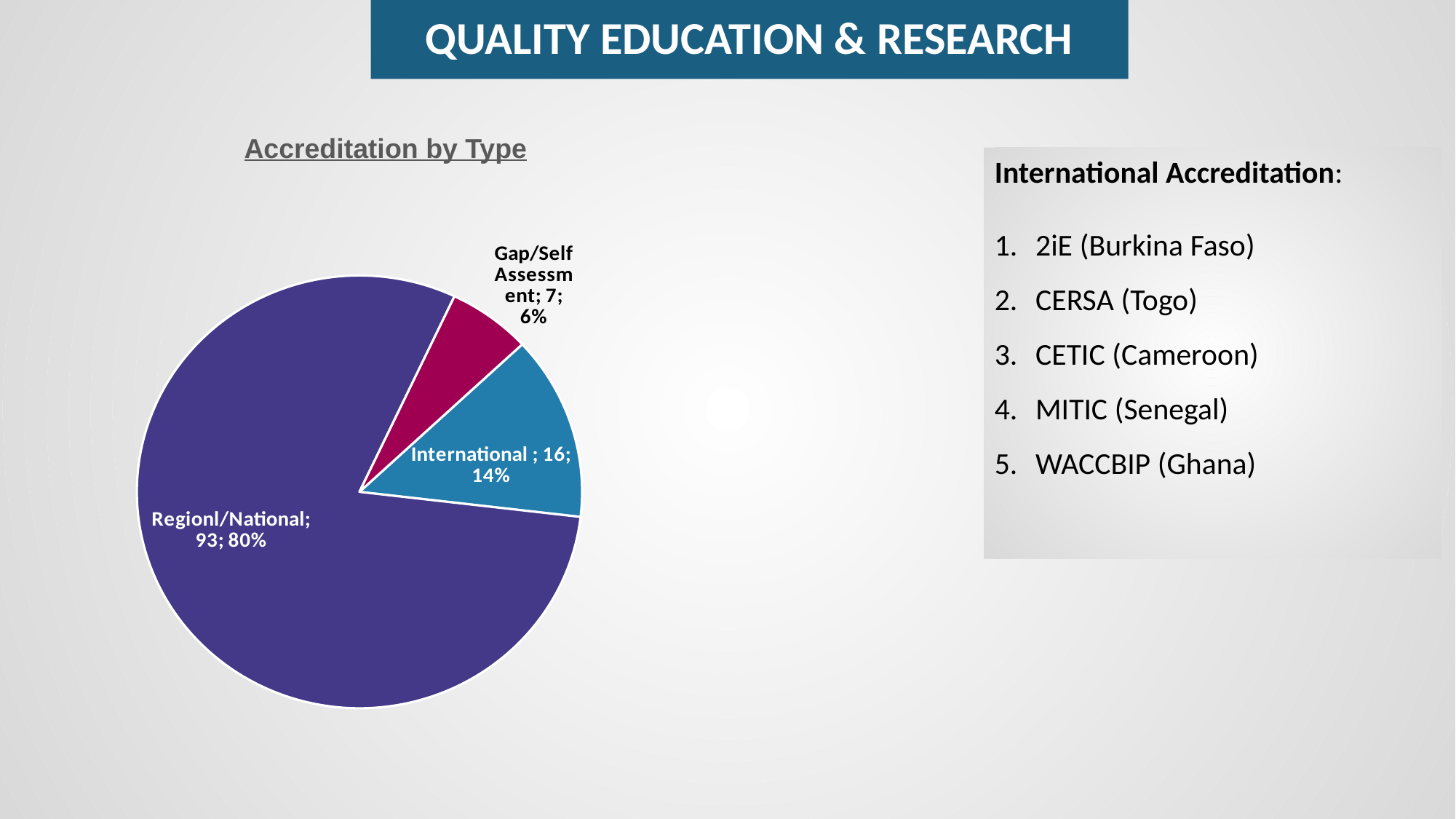
What is the title of the chart? Accreditation by Type What type of chart is shown on the slide? Pie chart Which category has the largest slice? Regionl/National What is the difference between the values for International and Gap/Self Assessment? 9 What is the value for Gap/Self Assessment? 7 How many slices does the pie chart have? 3 What share of the pie does Regionl/National represent? 80% What is the value for International? 16 What share of the pie does International represent? 14% Which category has the smallest slice? Gap/Self Assessment What share of the pie does Gap/Self Assessment represent? 6% What is the value for Regionl/National? 93